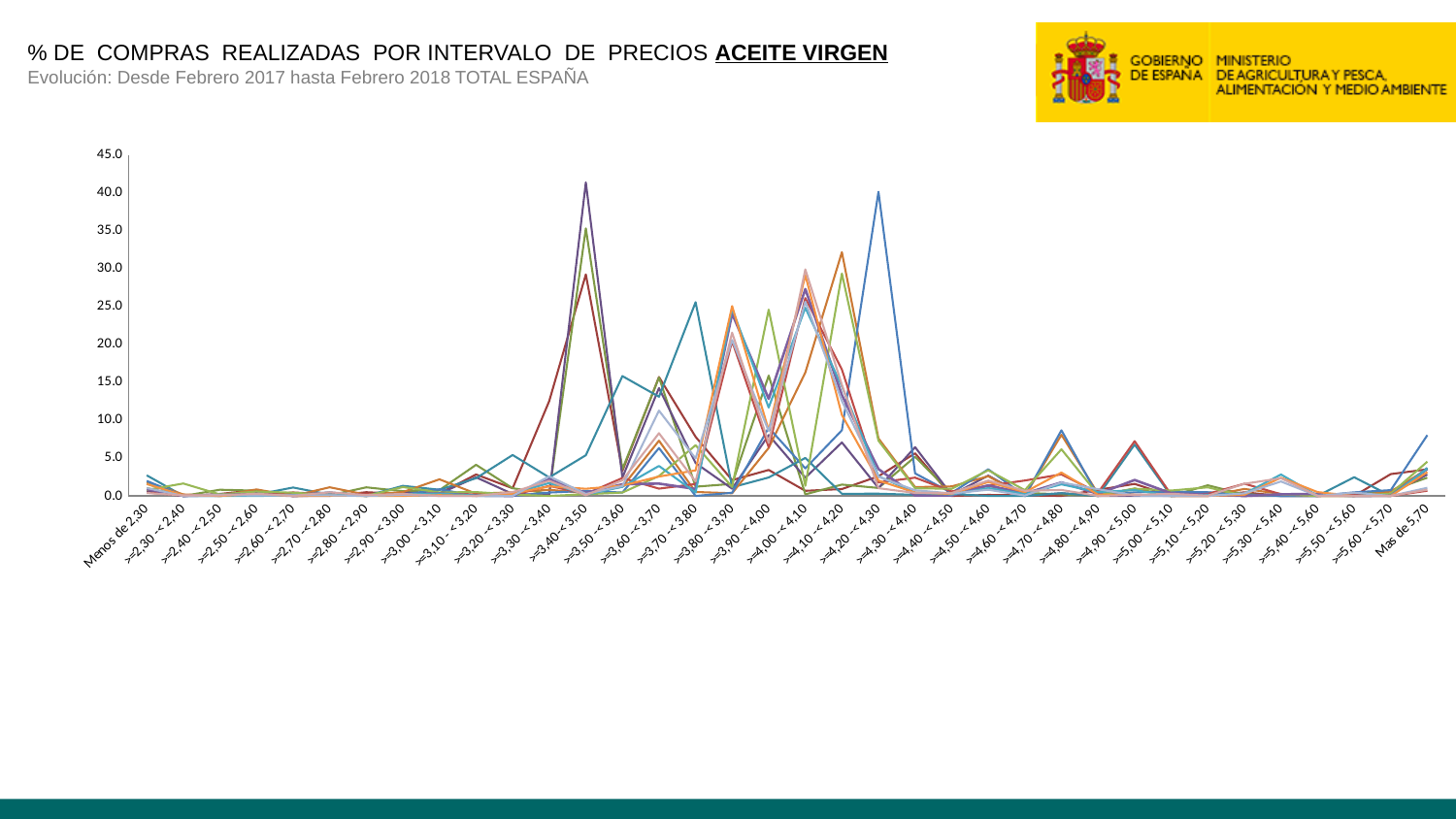
Is the highest value plotted at the interval >=3,40 - <3,50 greater or less than 35.0? greater Are all the values plotted at the interval Menos de 2,30 greater or less than 5.0? less Does the chart display a legend identifying the plotted series? No Is the highest value plotted at the interval >=4,20 - <4,30 greater or less than 25.0? greater How many price-interval categories are shown on the x axis of the chart? 36 What kind of chart is shown on the slide? Line chart What is the label of the first category on the x axis? Menos de 2,30 What is the highest tick value shown on the y axis of the chart? 45.0 What is the label of the last category on the x axis? Mas de 5,70